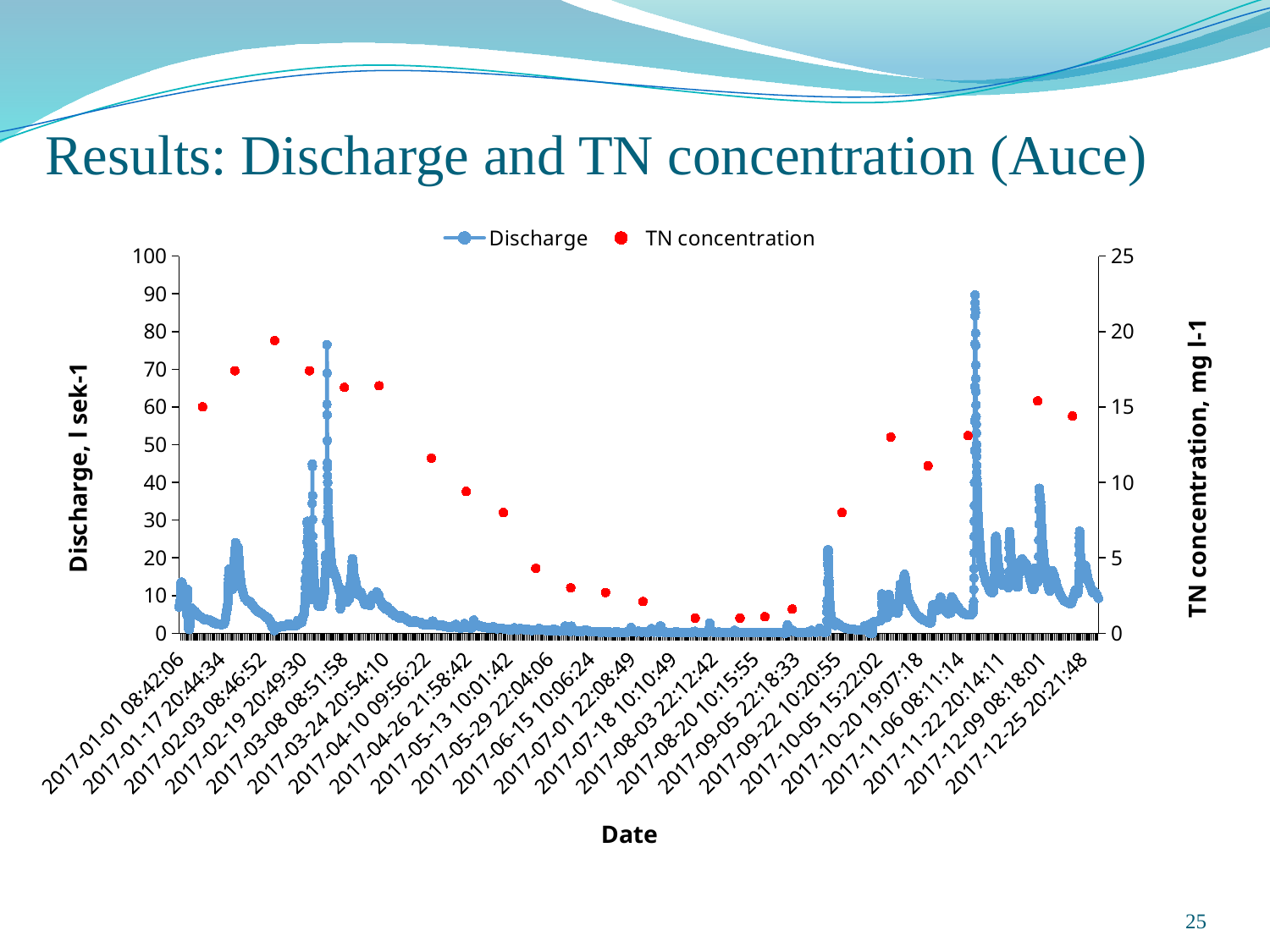
Which Discharge peak is higher: the one in early March 2017 or the one in late November 2017? Late November 2017 Is the highest Discharge peak (in late November 2017) greater or less than 80 on the left axis? greater What are the names of the two series in the legend? Discharge and TN concentration What kind of chart is shown on the slide? Line chart Is the highest TN concentration value greater or less than 15 on the right axis? greater Is the lowest TN concentration value (in August 2017) greater or less than 5 on the right axis? less What is the label of the left vertical axis? Discharge, l sek-1 Does the TN concentration rise or fall between September 2017 and December 2017? Rise What is the maximum value shown on the right vertical axis? 25 Does the TN concentration rise or fall between February 2017 and August 2017? Fall How many series does the legend list? 2